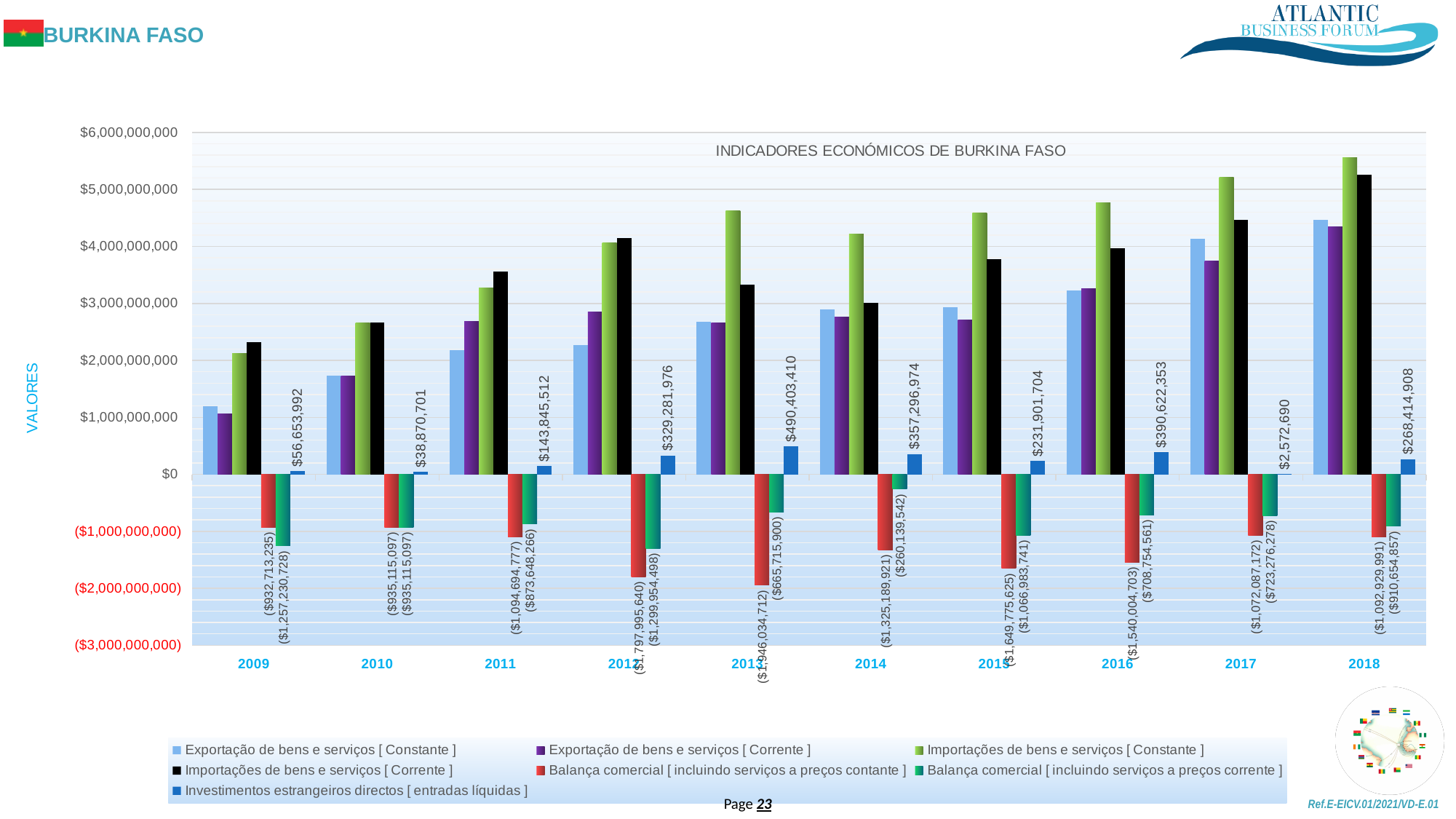
What is the value of Investimentos estrangeiros directos [ entradas líquidas ] for 2017? $2,572,690 Is the value for Importações de bens e serviços [ Constante ] in 2018 greater or less than $5,000,000,000? greater In which year is Investimentos estrangeiros directos [ entradas líquidas ] lowest? 2017 How many years are shown on the x axis of the chart? 10 What is the value of Balança comercial [ incluindo serviços a preços contante ] for 2013? ($1,946,034,712) What kind of chart is shown on the slide? Bar chart What is the value of Investimentos estrangeiros directos [ entradas líquidas ] for 2013? $490,403,410 Which year has the larger value for Investimentos estrangeiros directos [ entradas líquidas ], 2014 or 2016? 2016 How many series does the legend list? 7 In which year is Investimentos estrangeiros directos [ entradas líquidas ] highest? 2013 By how much did Investimentos estrangeiros directos [ entradas líquidas ] increase from 2012 to 2013? $161,121,434 What is the value of Balança comercial [ incluindo serviços a preços corrente ] for 2014? ($260,139,542)